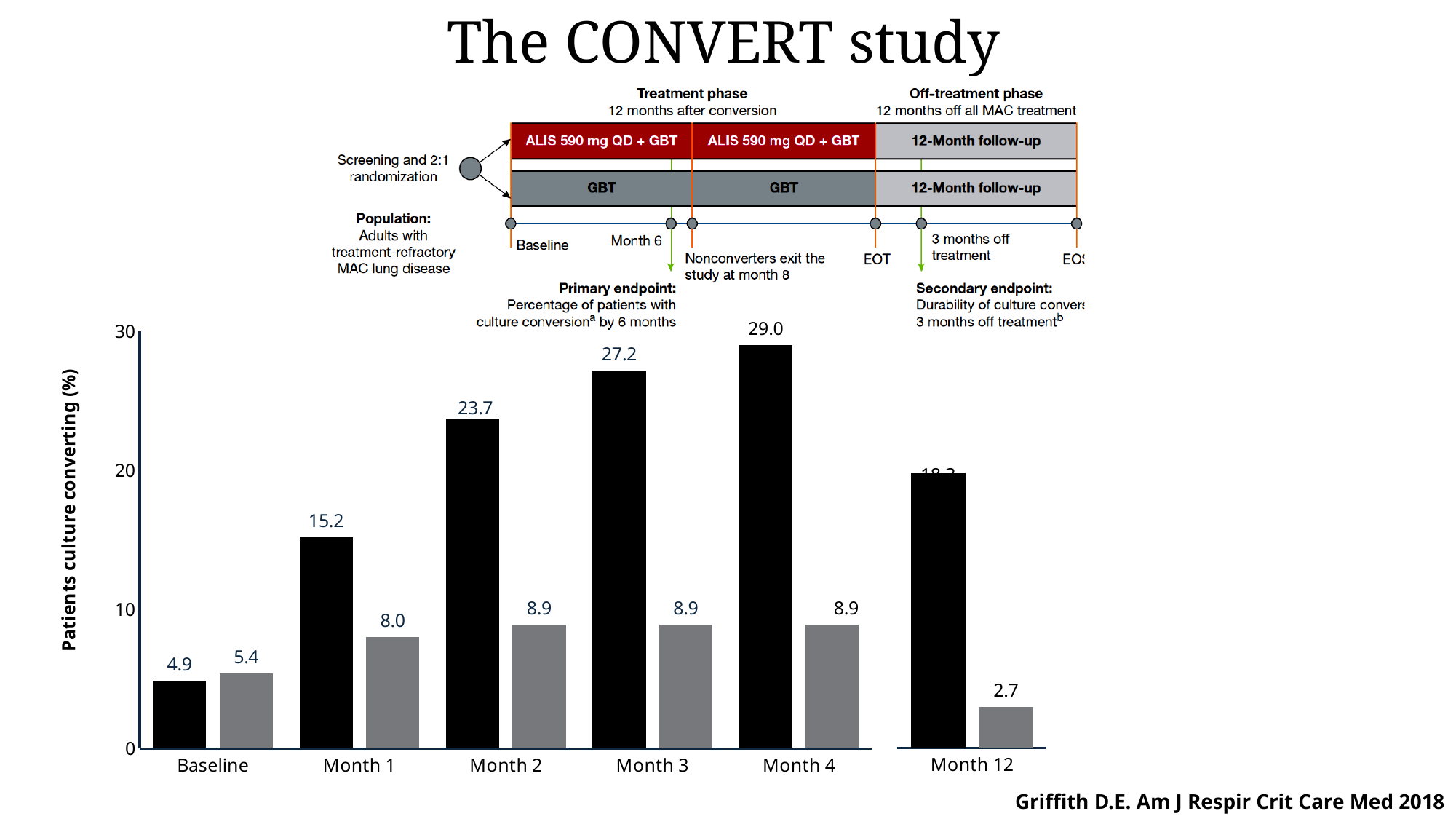
How many time-point categories are shown on the x axis of the bar chart? 6 At Baseline, which is larger, the black bar or the grey bar? The grey bar At which time point is the black bar highest? Month 4 What is the difference between the black bar at Month 4 and the black bar at Month 1? 13.8 What kind of chart is shown at the bottom of the slide? Bar chart Do the black bars rise or fall from Baseline to Month 4? Rise What is the value of the black bar at Month 2? 23.7 What is the value of the grey bar at Month 1? 8.0 At which time point is the black bar lowest? Baseline What is the value of the grey bar at Month 12? 2.7 What is the difference between the black bar and the grey bar at Month 3? 18.3 What is the value of the black bar at Month 4? 29.0